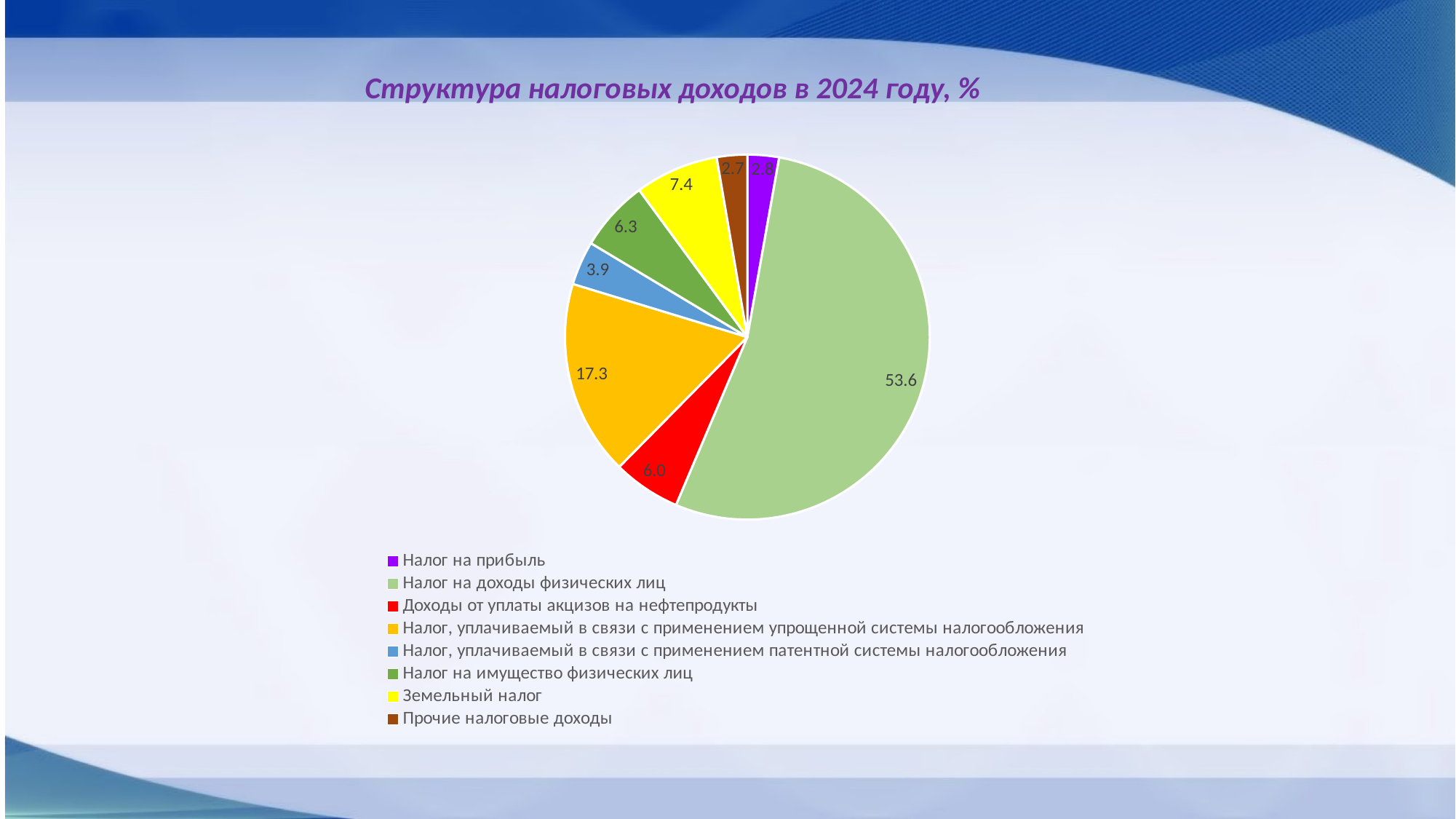
What colour is the slice for "Доходы от уплаты акцизов на нефтепродукты"? Red Which is larger: "Налог на имущество физических лиц" or "Налог, уплачиваемый в связи с применением патентной системы налогообложения"? Налог на имущество физических лиц What is the title of the chart? Структура налоговых доходов в 2024 году, % What share does "Налог на доходы физических лиц" have in the pie chart? 53.6 Which category has the smallest slice of the pie? Прочие налоговые доходы What type of chart is shown on the slide? Pie chart What is the value shown for "Земельный налог"? 7.4 How many categories does the legend list? 8 What is the difference between the values for "Налог, уплачиваемый в связи с применением упрощенной системы налогообложения" and "Доходы от уплаты акцизов на нефтепродукты"? 11.3 What is the value shown for "Налог, уплачиваемый в связи с применением упрощенной системы налогообложения"? 17.3 What is the value shown for "Налог на прибыль"? 2.8 Which category has the largest slice of the pie? Налог на доходы физических лиц